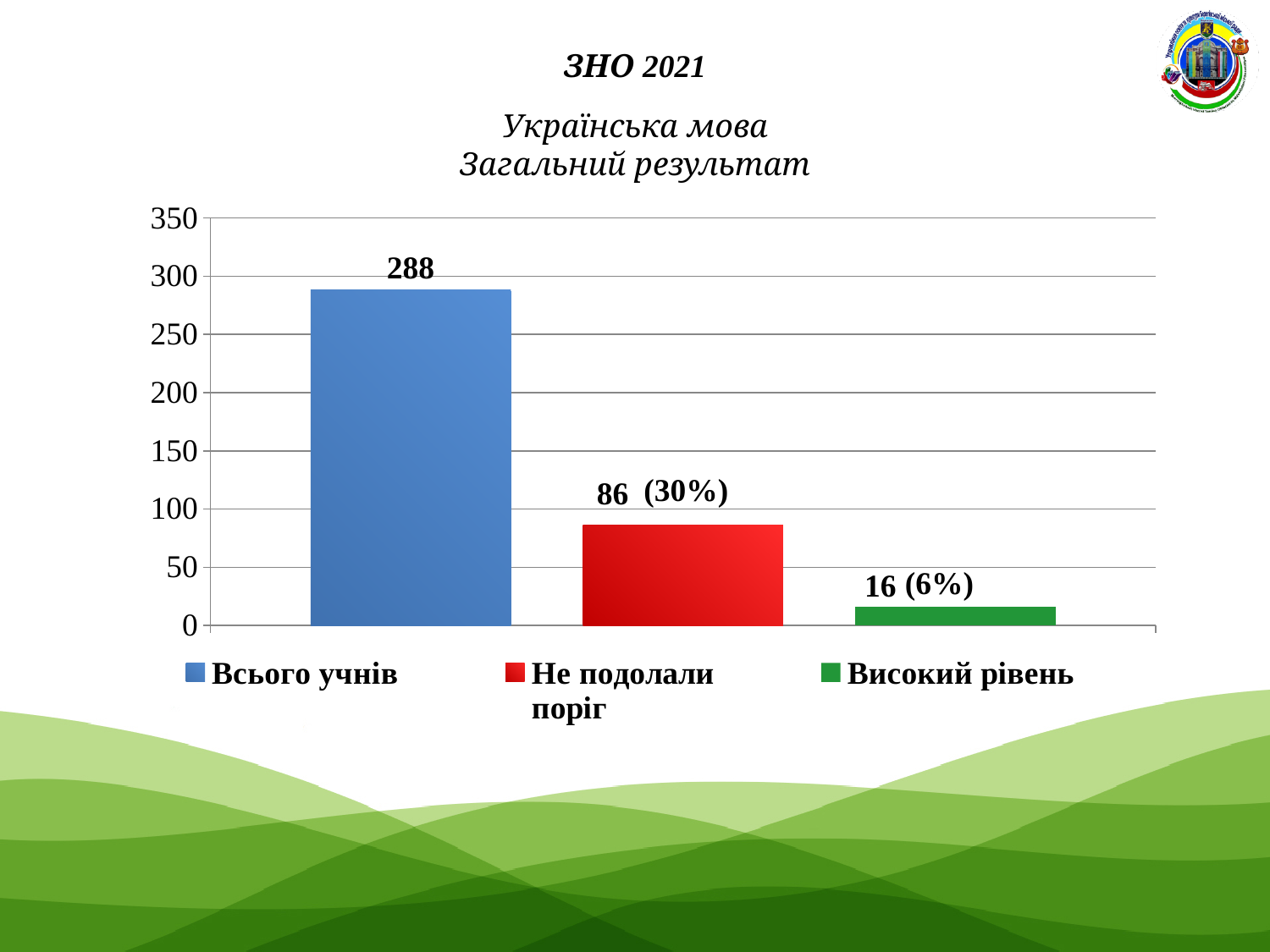
What kind of chart is shown on the slide? Bar chart How many series does the legend list? 3 Which is larger, the value for Не подолали поріг or the value for Високий рівень? Не подолали поріг What is the value for Високий рівень? 16 Which series has the highest value? Всього учнів What is the value for Не подолали поріг? 86 What percentage is shown next to the value for Не подолали поріг? 30% What percentage is shown next to the value for Високий рівень? 6% What is the difference between the values for Всього учнів and Не подолали поріг? 202 What is the value for Всього учнів? 288 What is the difference between the values for Не подолали поріг and Високий рівень? 70 Which series has the lowest value? Високий рівень